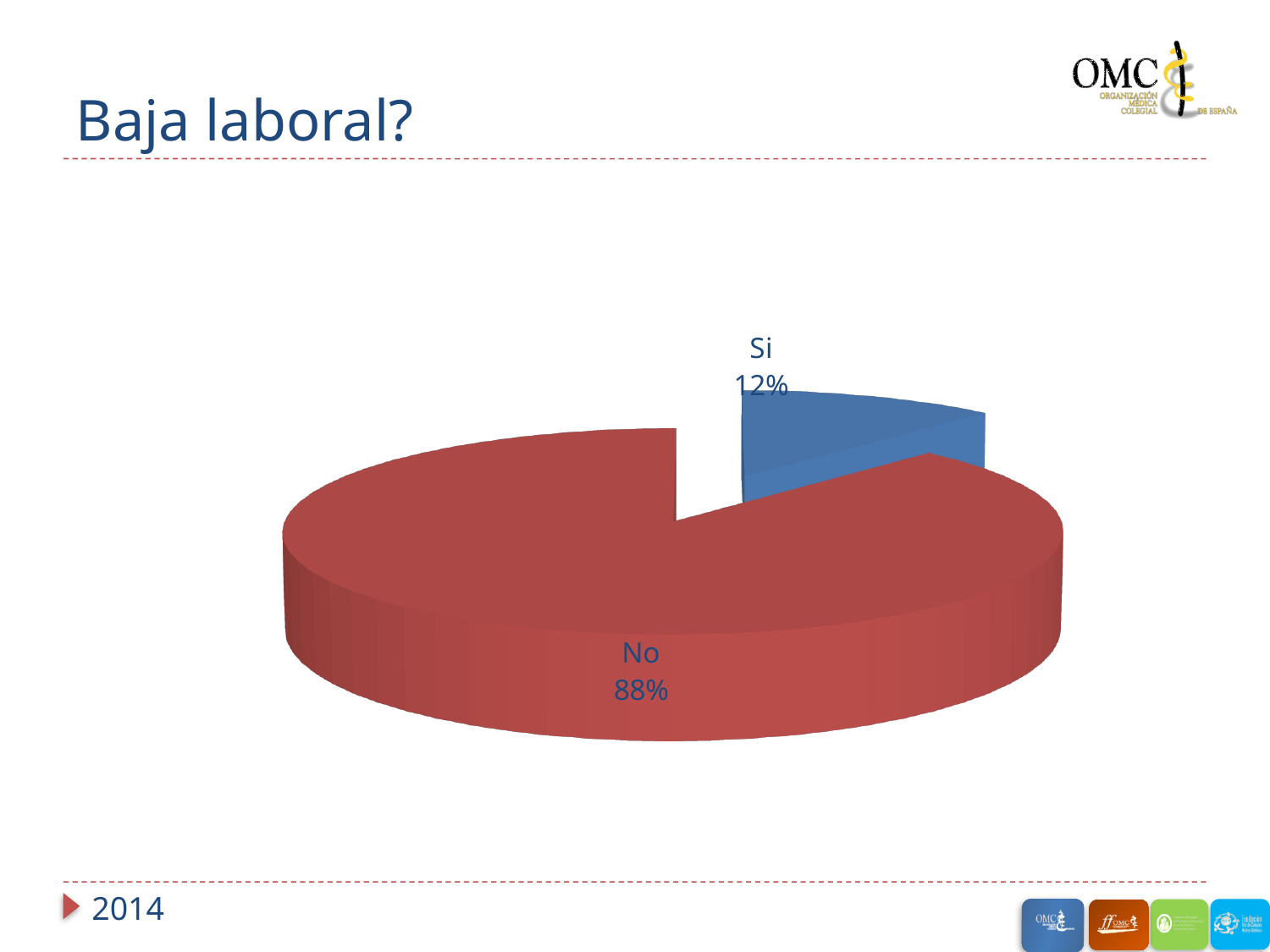
Which slice of the pie is the smallest? Si What type of chart is shown on the slide? pie chart How many slices does the pie chart have? 2 Which slice of the pie is the largest? No What percentage of the pie is labelled "Si"? 12% What is the title of the slide containing the pie chart? Baja laboral? What is the difference in percentage points between the "No" and "Si" slices? 76 What percentage of the pie is labelled "No"? 88% Which is larger, the "Si" slice or the "No" slice? No What share of the pie does the "Si" slice represent? 12% What colour is the "Si" slice of the pie chart? blue